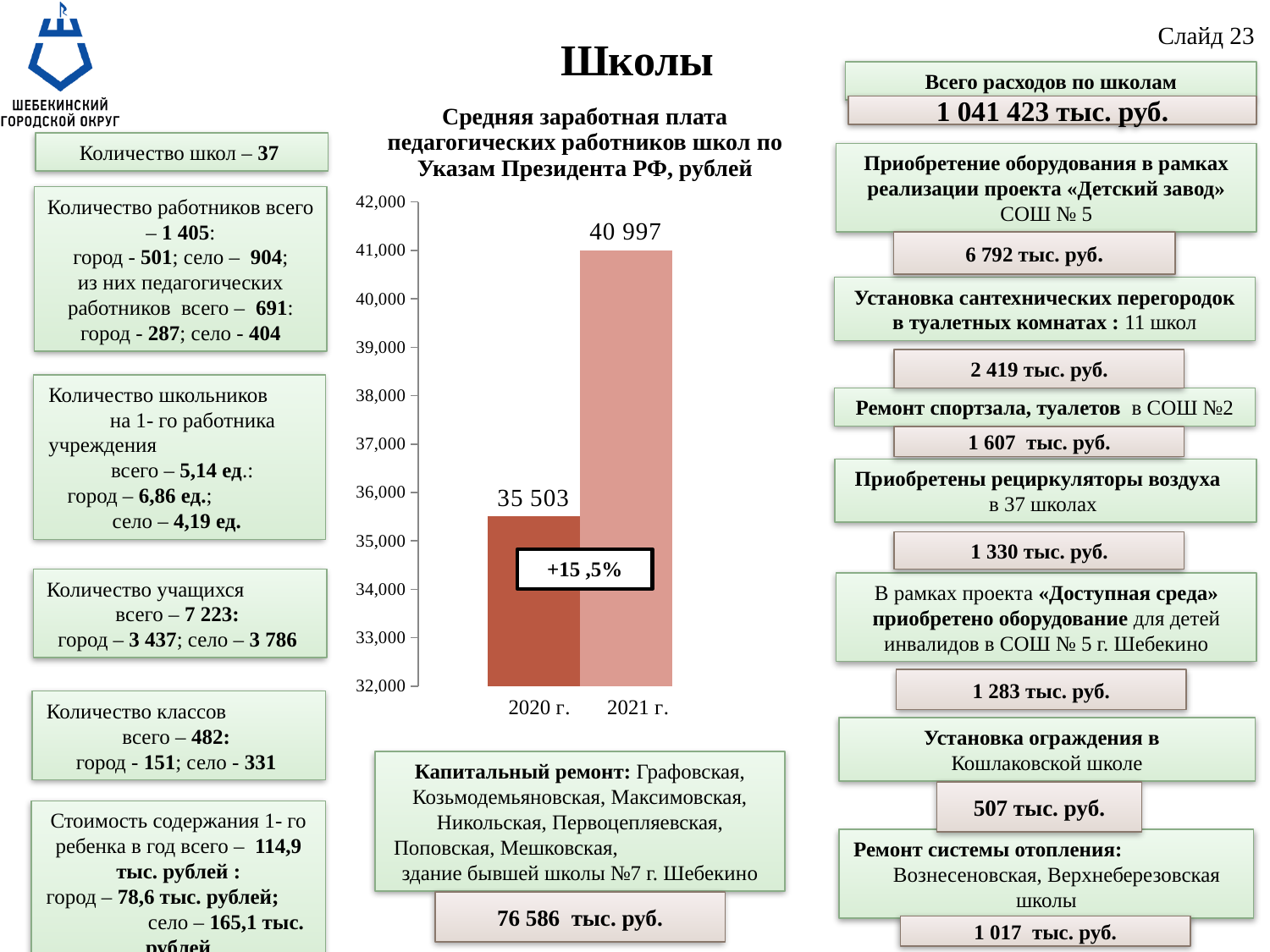
What kind of chart is shown on the slide? bar chart Is the value for 2021 г. greater or less than 40,000? greater What is the difference between the 2021 г. and 2020 г. values in the chart? 5 494 How many bars are shown in the chart? 2 Is the value for 2021 г. larger or smaller than the value for 2020 г.? larger Which year has the higher value in the chart? 2021 г. Do the values rise or fall from 2020 г. to 2021 г.? rise Which year has the lower value in the chart? 2020 г. What is the value for 2020 г. in the chart? 35 503 What is the value for 2021 г. in the chart? 40 997 What percentage change is printed on the chart between the two bars? +15 ,5% Is the value for 2020 г. greater or less than 36,000? less